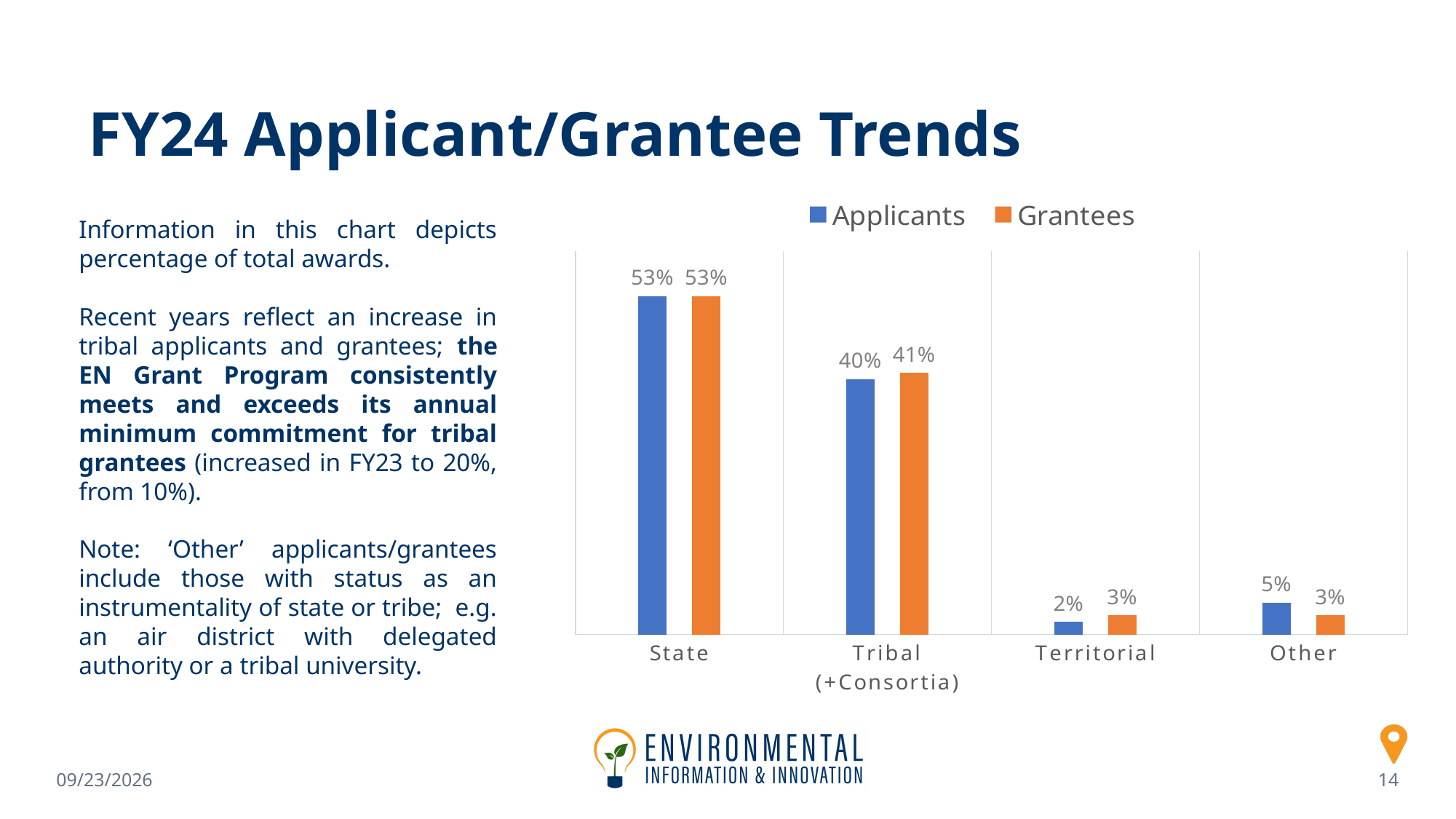
What percentage of Applicants are State? 53% How many categories are shown on the x axis? 4 What is the Applicants value for Territorial? 2% Which category has the lowest Grantees value? Territorial and Other (both 3%) What kind of chart is shown on the slide? Bar chart Which category has the highest Applicants value? State How many series does the legend list? 2 What is the difference between the Applicants values for State and Tribal (+Consortia)? 13% What colour are the Grantees bars? Orange For Other, which is larger: Applicants or Grantees? Applicants What is the Grantees value for Other? 3% What percentage of Grantees are Tribal (+Consortia)? 41%